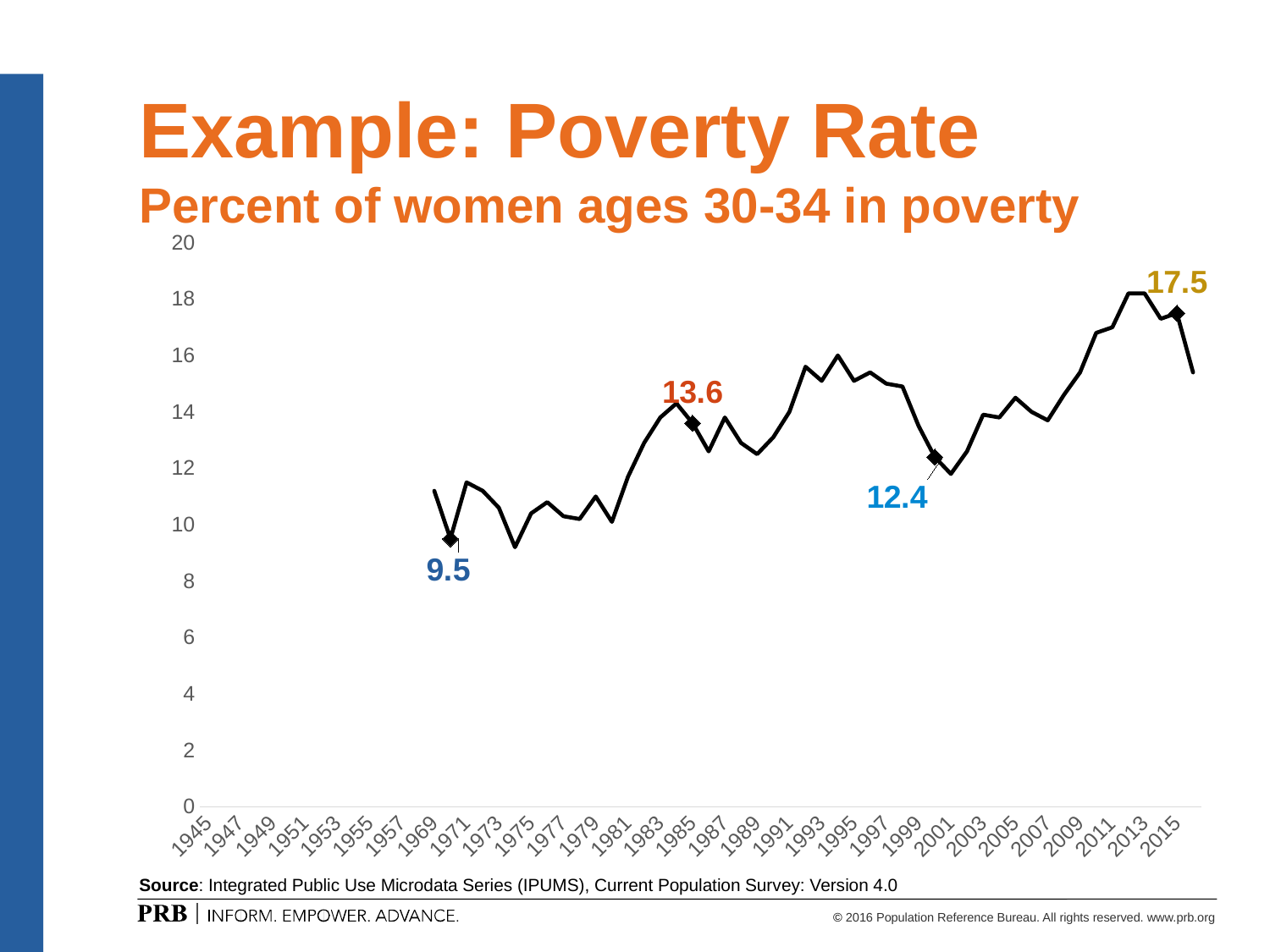
What is the difference between the labeled values 17.5 and 9.5? 8 Which labeled value is larger, the one marked 13.6 in the mid-1980s or the one marked 12.4 around 2000? 13.6 What is the difference between the labeled values 13.6 and 12.4? 1.2 What is the highest labeled value on the line? 17.5 What kind of chart is shown on the slide? line chart Overall, does the poverty rate rise or fall from the late 1960s to the 2010s? rise What is the maximum value shown on the vertical axis? 20 What is the lowest labeled value on the line? 9.5 Is the value around 2007 greater or less than 16? less Is the value around 2013 greater or less than 16? greater What is the subtitle describing what the chart plots? Percent of women ages 30-34 in poverty How many data points on the line have printed value labels? 4